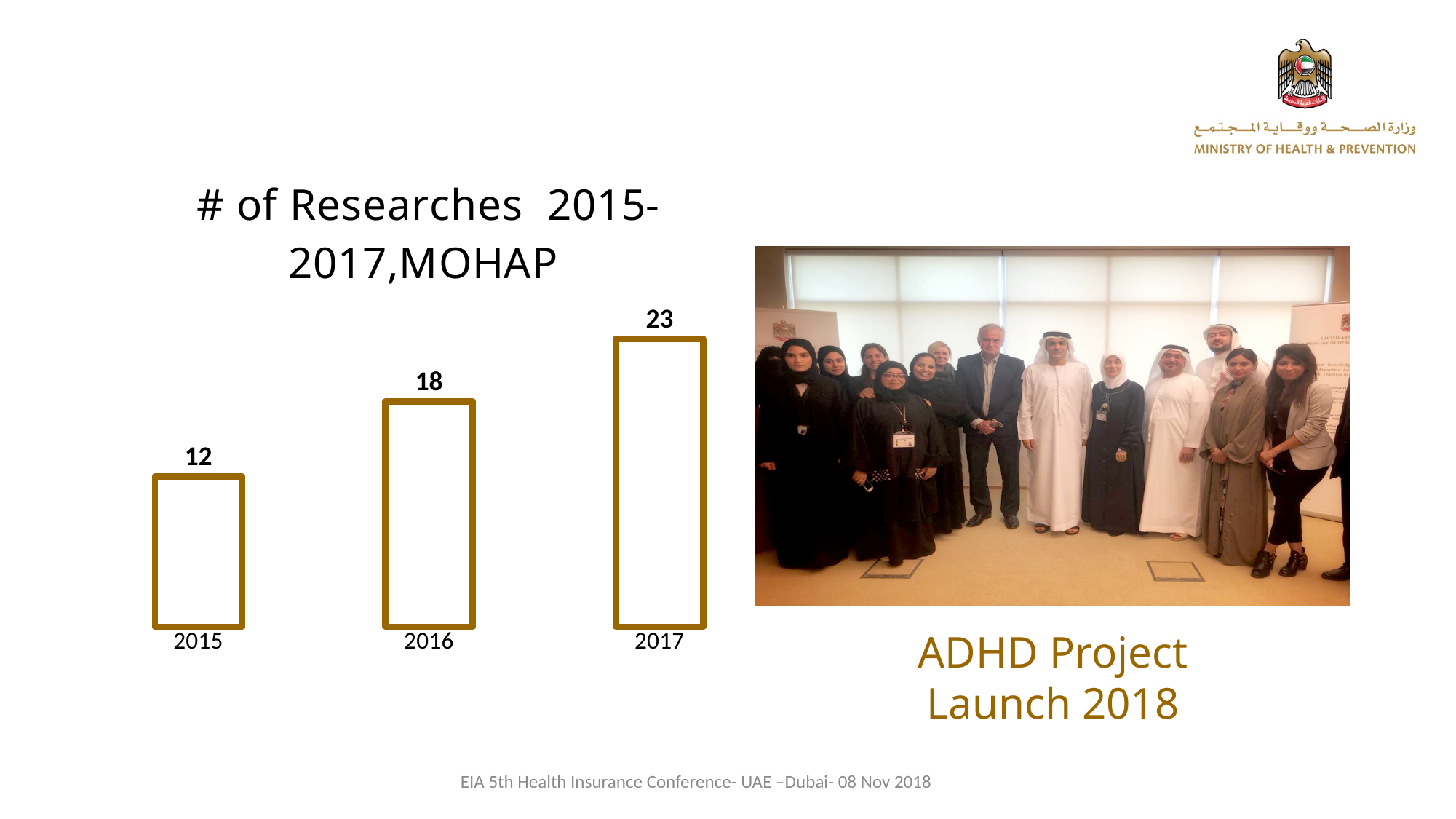
Which year has the lowest number of researches? 2015 Do the number of researches rise or fall from 2015 to 2017? Rise Which year has more researches, 2016 or 2017? 2017 What is the number of researches for 2017? 23 What is the number of researches for 2016? 18 Which year has the highest number of researches? 2017 What is the number of researches for 2015? 12 What is the title of the chart? # of Researches 2015-2017,MOHAP How many years are shown in the chart? 3 What is the difference between the number of researches in 2016 and 2015? 6 What is the difference between the number of researches in 2017 and 2015? 11 What kind of chart is shown on the slide? Bar chart